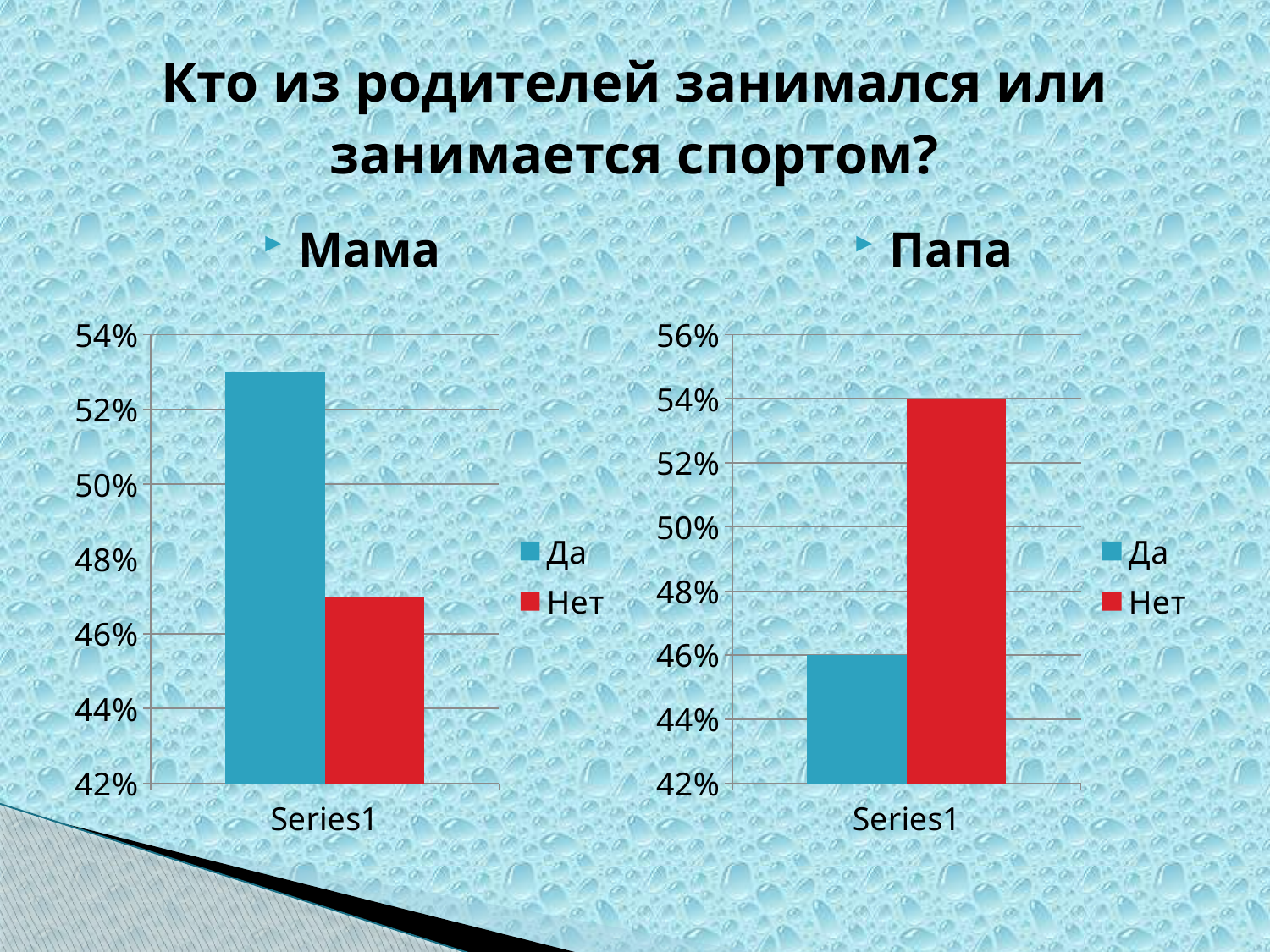
In the Мама chart, which is larger, Да or Нет? Да In the Папа chart, what is the value for Нет? 54% In the Папа chart, which is larger, Да or Нет? Нет In the Папа chart, which series has the lowest value? Да What kind of chart is the Папа chart? bar chart In the Мама chart, which series has the highest value? Да In the Папа chart, what is the difference between Нет and Да? 8% In the Мама chart, is the value for Да greater or less than 52%? greater In the Папа chart, is the value for Да greater or less than 48%? less In the Папа chart, what is the value for Да? 46% In the Мама chart, is the value for Нет greater or less than 48%? less How many series does the legend of the Мама chart list? 2